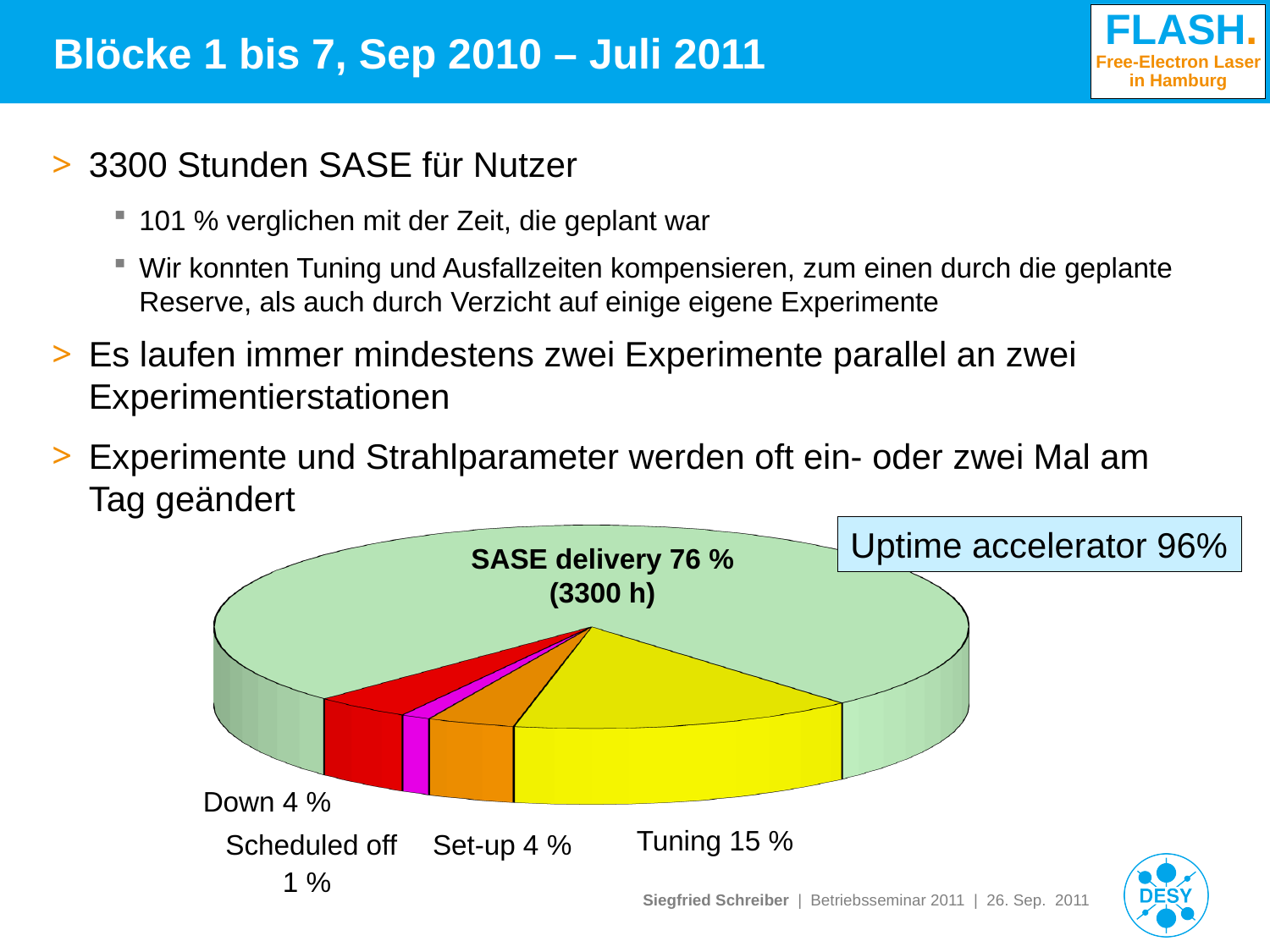
Which slice of the pie chart is the largest? SASE delivery What percentage of the pie chart is Scheduled off? 1 % How many slices does the pie chart have? 5 What kind of chart is shown on the slide? pie chart What share of the pie chart is SASE delivery? 76 % What percentage of the pie chart is Set-up? 4 % What colour is the Tuning slice in the pie chart? yellow How many hours of SASE delivery does the pie chart label show? 3300 h Which is larger in the pie chart, Tuning or Down? Tuning What is the difference in percentage points between SASE delivery and Tuning in the pie chart? 61 Which slice of the pie chart is the smallest? Scheduled off